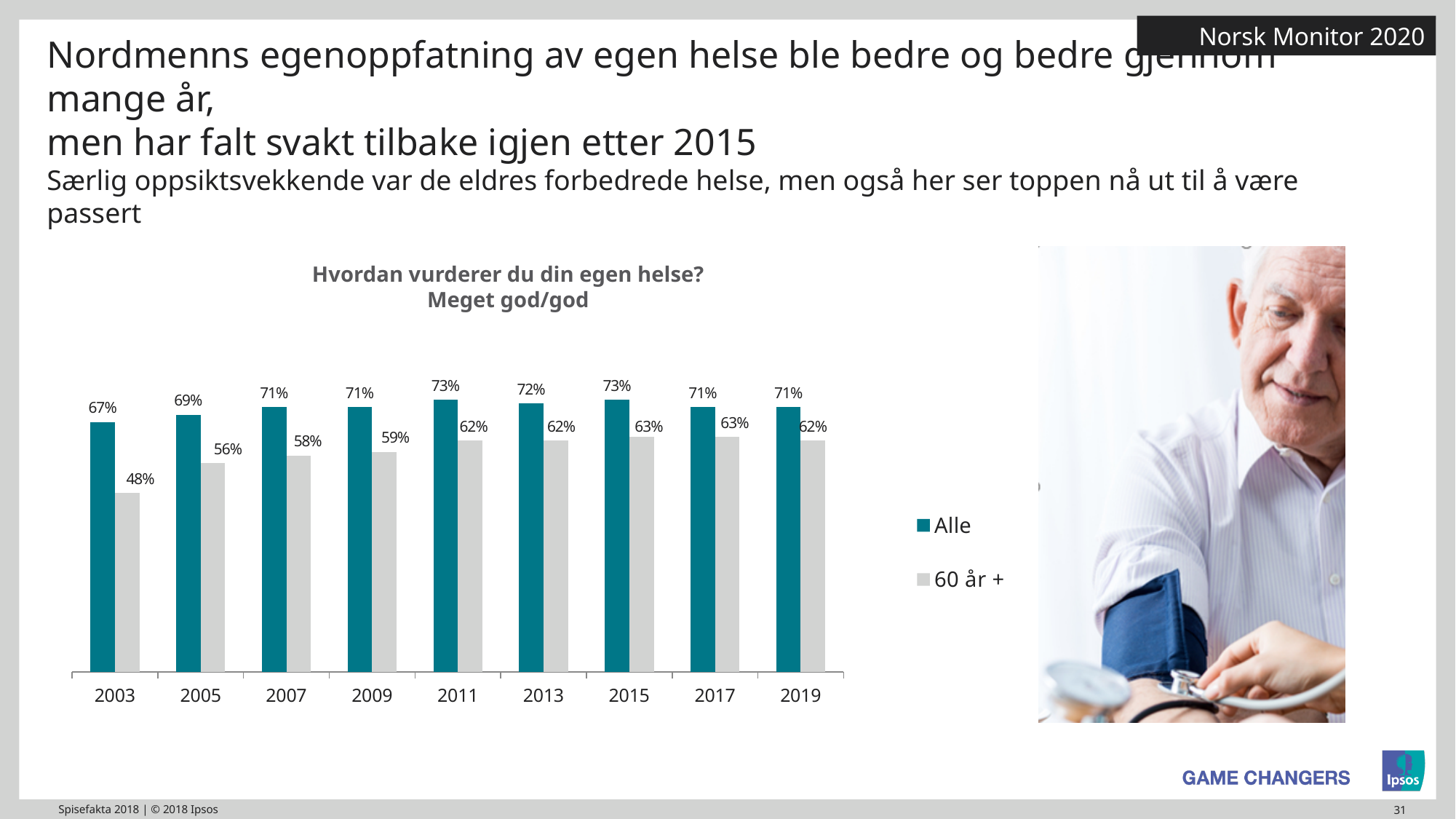
What is the value for "Alle" in 2003? 67% Which is larger in 2015, the value for "Alle" or for "60 år +"? Alle What is the value for "60 år +" in 2019? 62% What is the difference between the "60 år +" values in 2019 and 2003? 14 percentage points How many series does the legend list? 2 How many years are shown on the x axis? 9 What kind of chart is shown on the slide? Bar chart What is the difference between the "Alle" and "60 år +" values in 2003? 19 percentage points What is the value for "60 år +" in 2003? 48% Does the "60 år +" series rise or fall from 2003 to 2015? Rise In which year is the "60 år +" series lowest? 2003 What is the title of the chart? Hvordan vurderer du din egen helse? Meget god/god